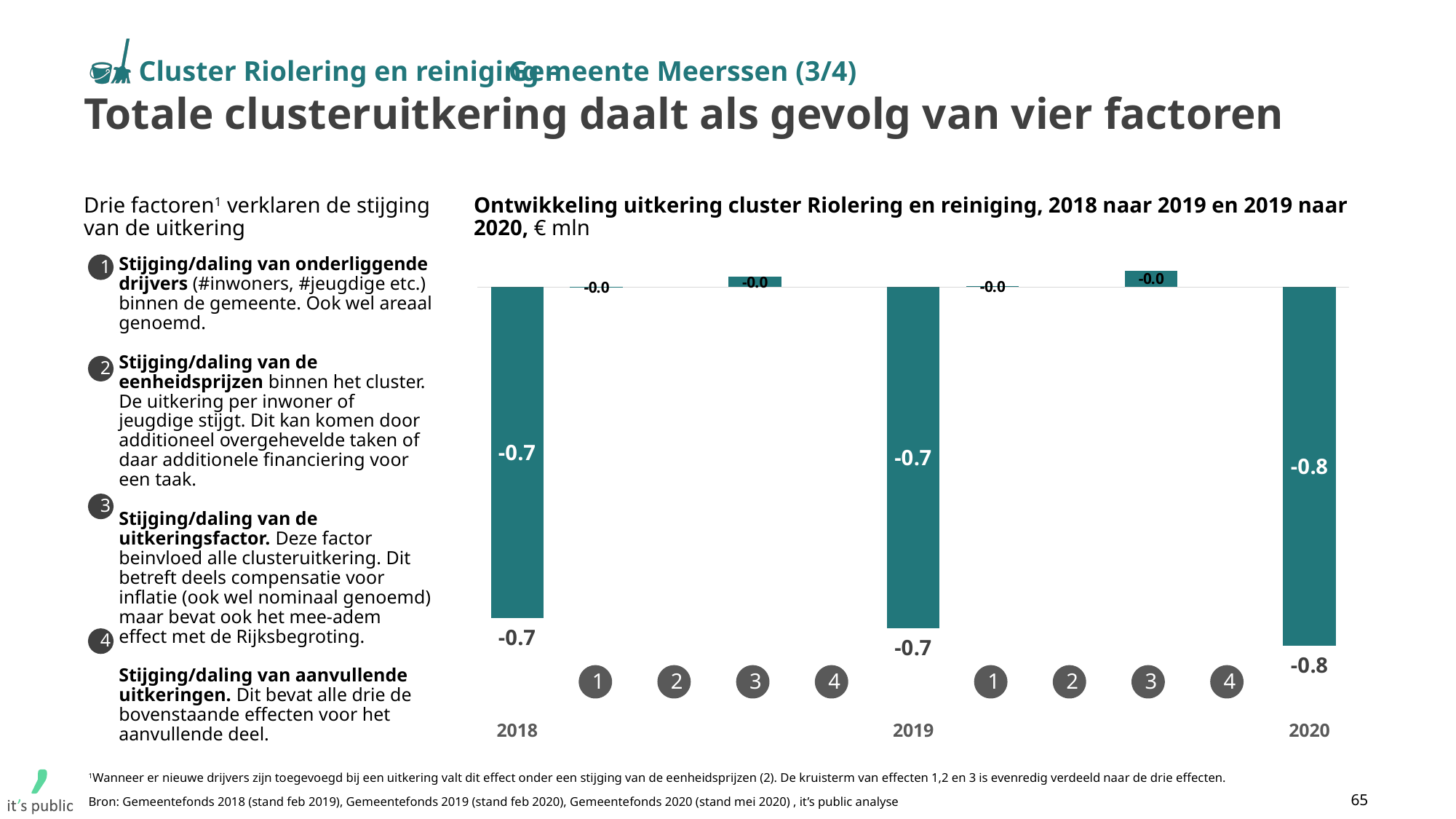
In what unit are the values in the chart expressed? € mln Which year has the lowest (most negative) total value in the chart? 2020 What is the value of the 2019 bar in the chart? -0.7 What value is labelled for factor 1 in the change from 2018 to 2019? -0.0 What is the value of the 2018 bar in the chart? -0.7 What kind of chart is shown on the slide? Bar chart What is the value of the 2020 bar in the chart? -0.8 What value is labelled for factor 3 in the change from 2019 to 2020? -0.0 What is the difference between the 2020 value and the 2018 value? 0.1 How many year totals (2018, 2019, 2020) are shown in the chart? 3 Do the year totals rise or fall from 2018 to 2020? Fall Which is larger, the value for 2018 or the value for 2020? 2018